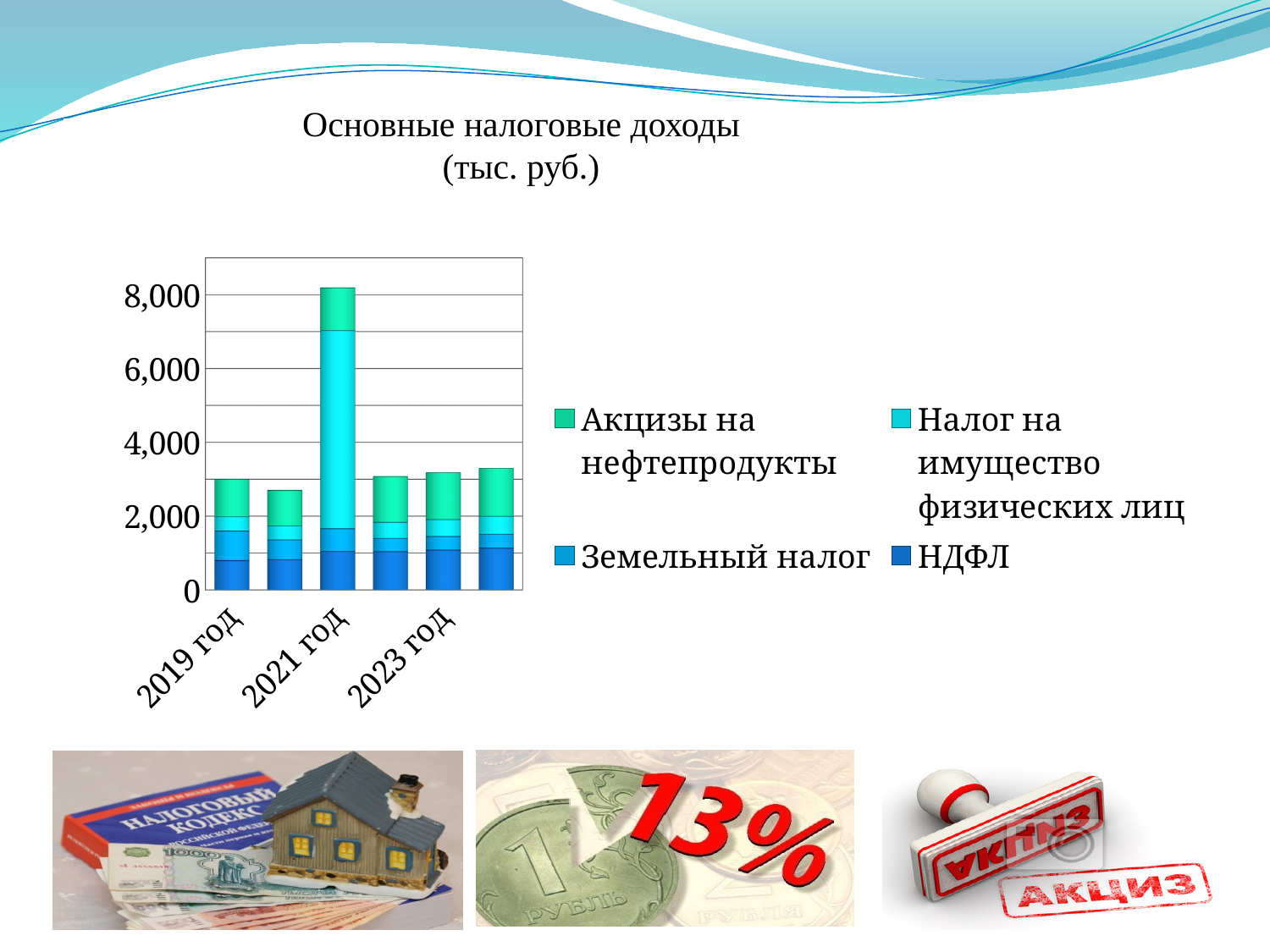
How many series does the legend list? 4 Is the total for 2019 год greater or less than 4,000? less Which series is shown in the darkest blue at the bottom of each bar? НДФЛ Is the НДФЛ value for 2021 год greater or less than 2,000? less What kind of chart is shown on the slide? Stacked bar chart Which has the larger total, 2019 год or 2021 год? 2021 год How many bars are plotted in the chart? 6 What is the title of the chart? Основные налоговые доходы (тыс. руб.) Which labeled year has the tallest stacked bar? 2021 год Is the total for 2023 год greater or less than 2,000? greater